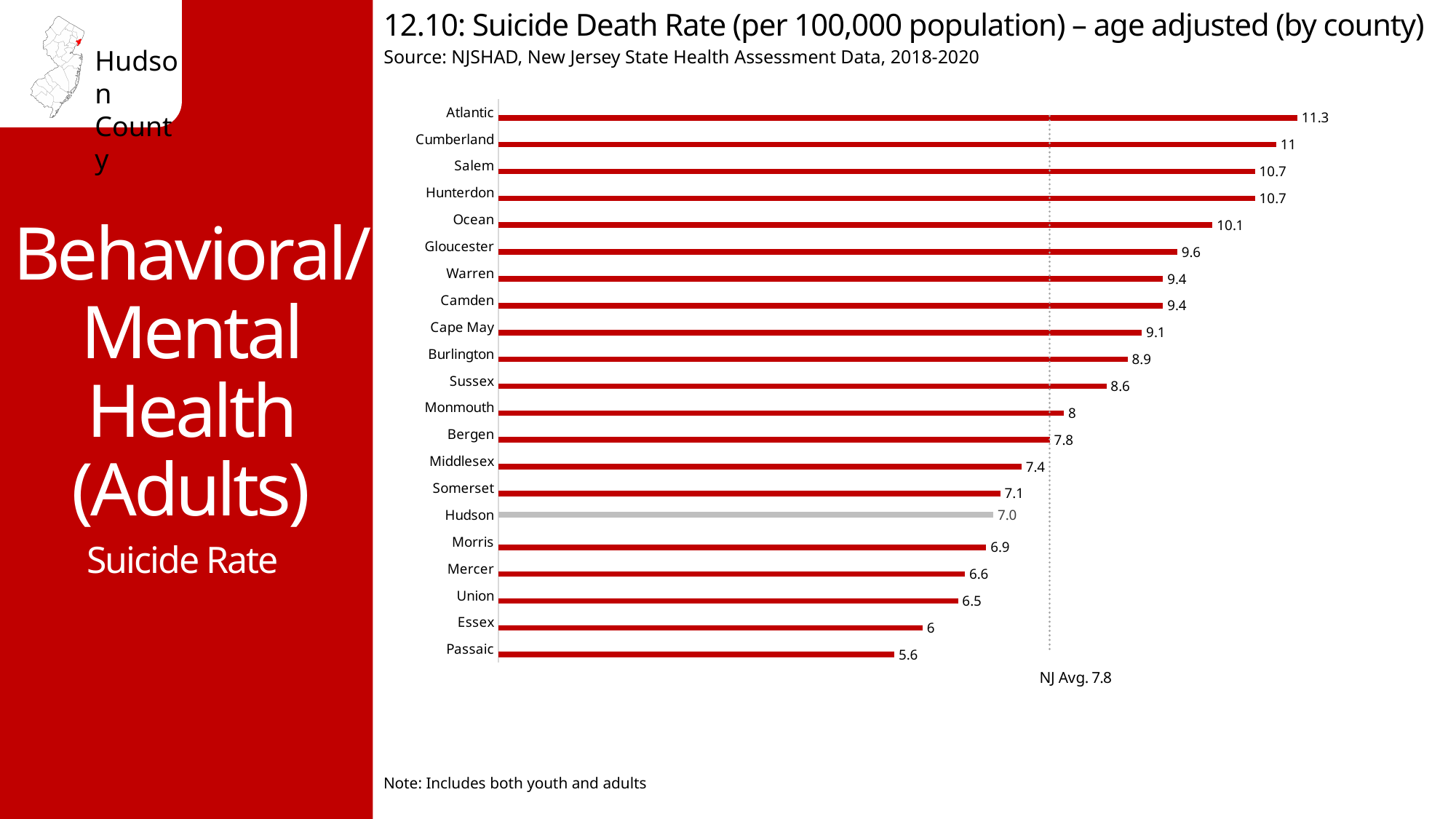
What type of chart is used on this slide? Bar chart Which has a higher suicide death rate, Ocean or Gloucester? Ocean What is the difference between the suicide death rate of Hudson County and the NJ average? 0.8 Which county has the highest suicide death rate? Atlantic Which county has the lowest suicide death rate? Passaic Is the suicide death rate for Hudson County greater or less than the NJ average of 7.8? less What is the suicide death rate for Atlantic County? 11.3 What is the suicide death rate for Passaic County? 5.6 How many counties are shown in the chart? 21 What is the suicide death rate for Hudson County? 7.0 What is the difference between the suicide death rates of Atlantic and Passaic counties? 5.7 What is the NJ average suicide death rate shown on the chart? 7.8